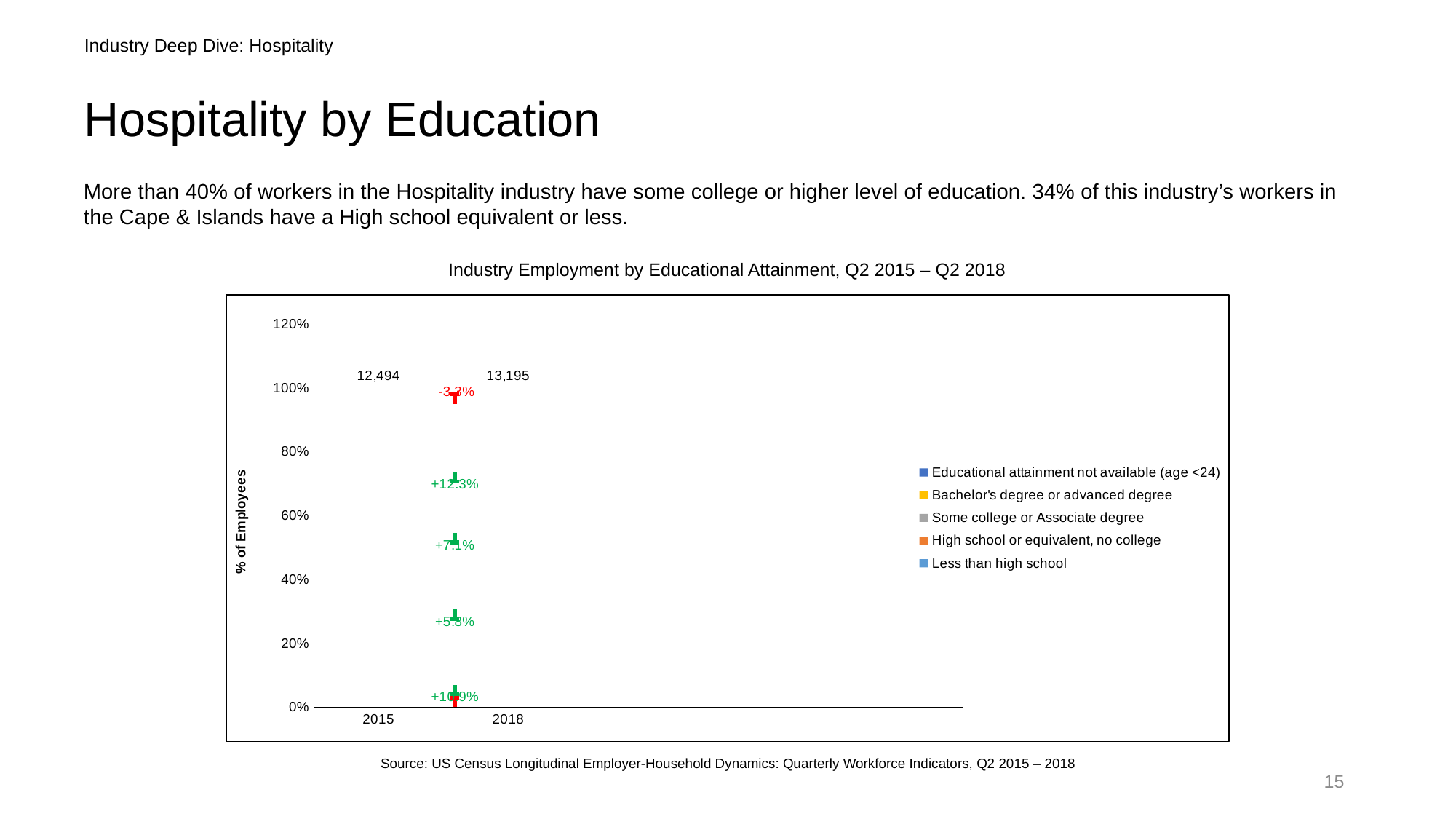
How many years are shown on the x axis of the chart? 2 Is the total employment figure printed for 2015 greater or less than 13,000? less Which year has the larger total employment figure printed on the chart, 2015 or 2018? 2018 What is the title of the chart? Industry Employment by Educational Attainment, Q2 2015 – Q2 2018 What total employment figure is printed above the 2018 column in the chart? 13,195 What total employment figure is printed above the 2015 column in the chart? 12,494 Is the total employment figure printed for 2018 greater or less than 13,000? greater How many series does the chart legend list? 5 What is the difference between the total employment figures printed for 2018 and 2015? 701 What is the label on the vertical axis of the chart? % of Employees